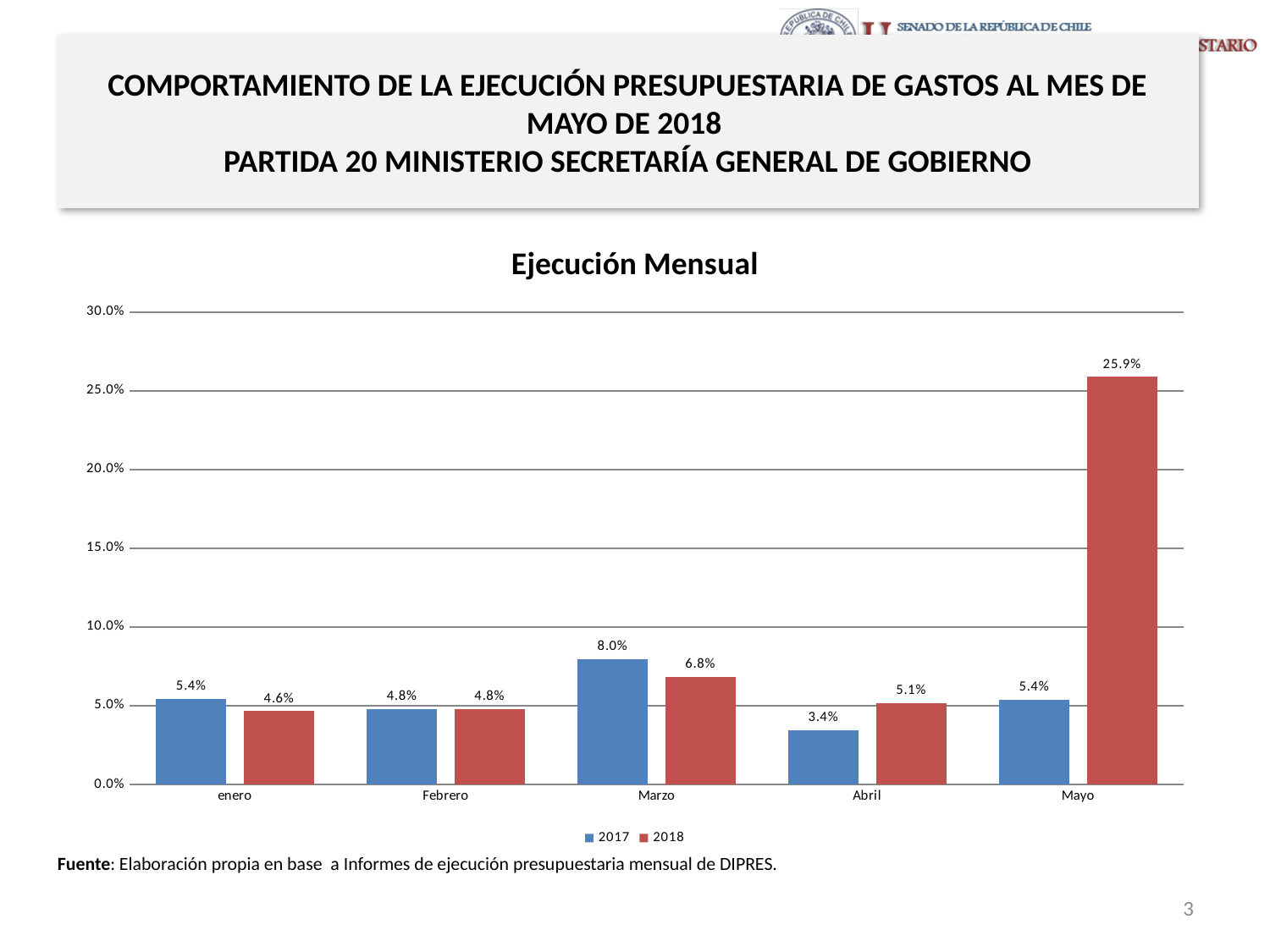
What is the value for 2017 in Marzo? 8.0% What is the difference between the 2018 and 2017 values in Mayo? 20.5% What kind of chart is shown on the slide? Bar chart Which month has the highest value for the 2018 series? Mayo How many months are shown on the x axis? 5 Which month has the lowest value for the 2017 series? Abril What is the value for 2018 in enero? 4.6% How many series does the legend list? 2 What is the title of the chart? Ejecución Mensual What is the value for 2017 in Abril? 3.4% What is the value for 2018 in Mayo? 25.9% Which is larger in Marzo, the 2017 value or the 2018 value? 2017